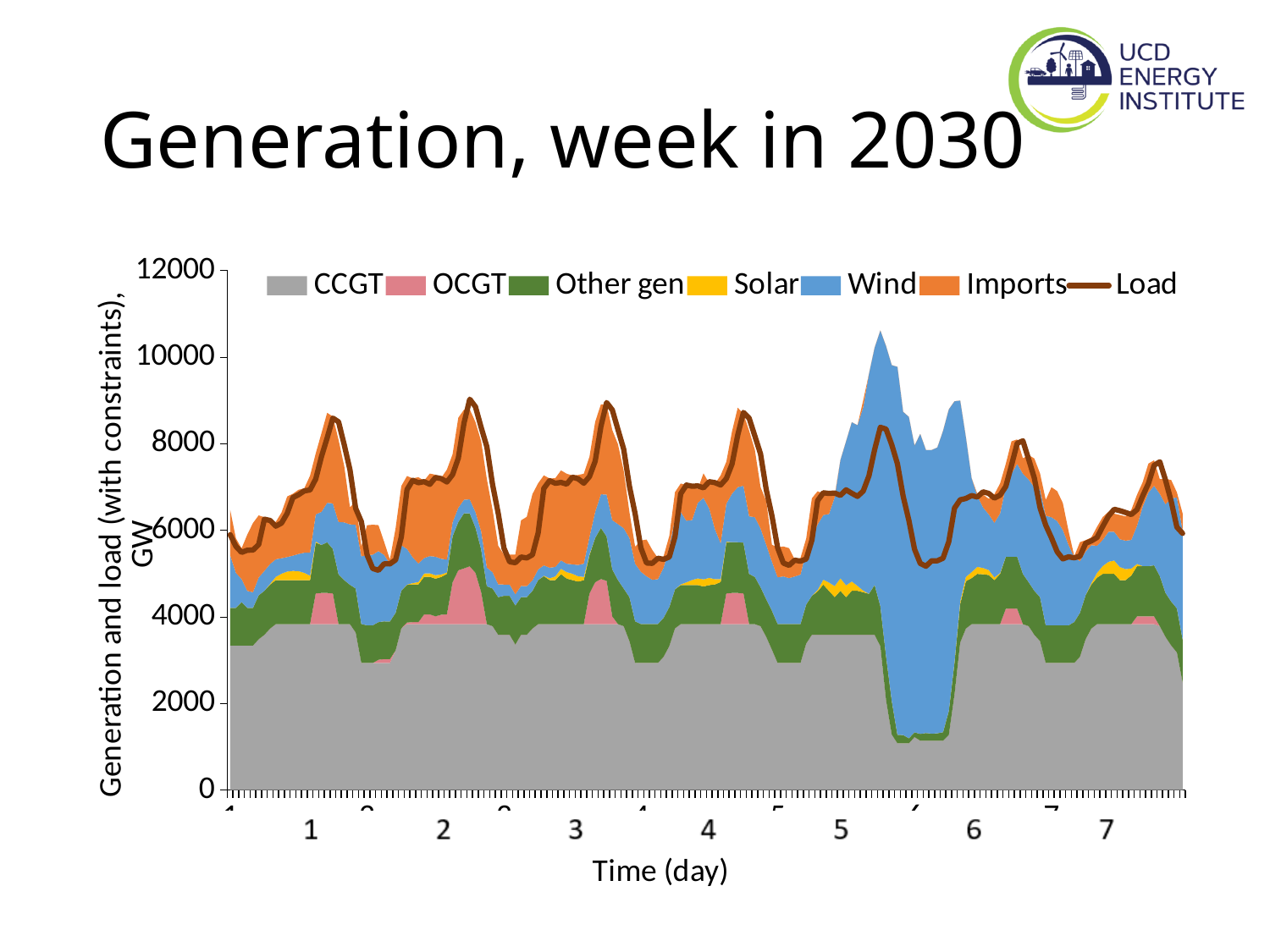
Is the lowest point of the Load line during the week greater or less than 4000? greater What is the title of the slide's chart? Generation, week in 2030 What kind of chart is shown on the slide? Stacked area chart with a line overlay Is the peak of the Load line on day 2 greater or less than 8000? greater How many series does the legend list? 7 Is the peak of the total stacked generation on day 5 greater or less than 10000? greater What is the label of the x axis? Time (day) How many days are labelled along the x axis? 7 Which series is drawn as a line rather than a filled area? Load